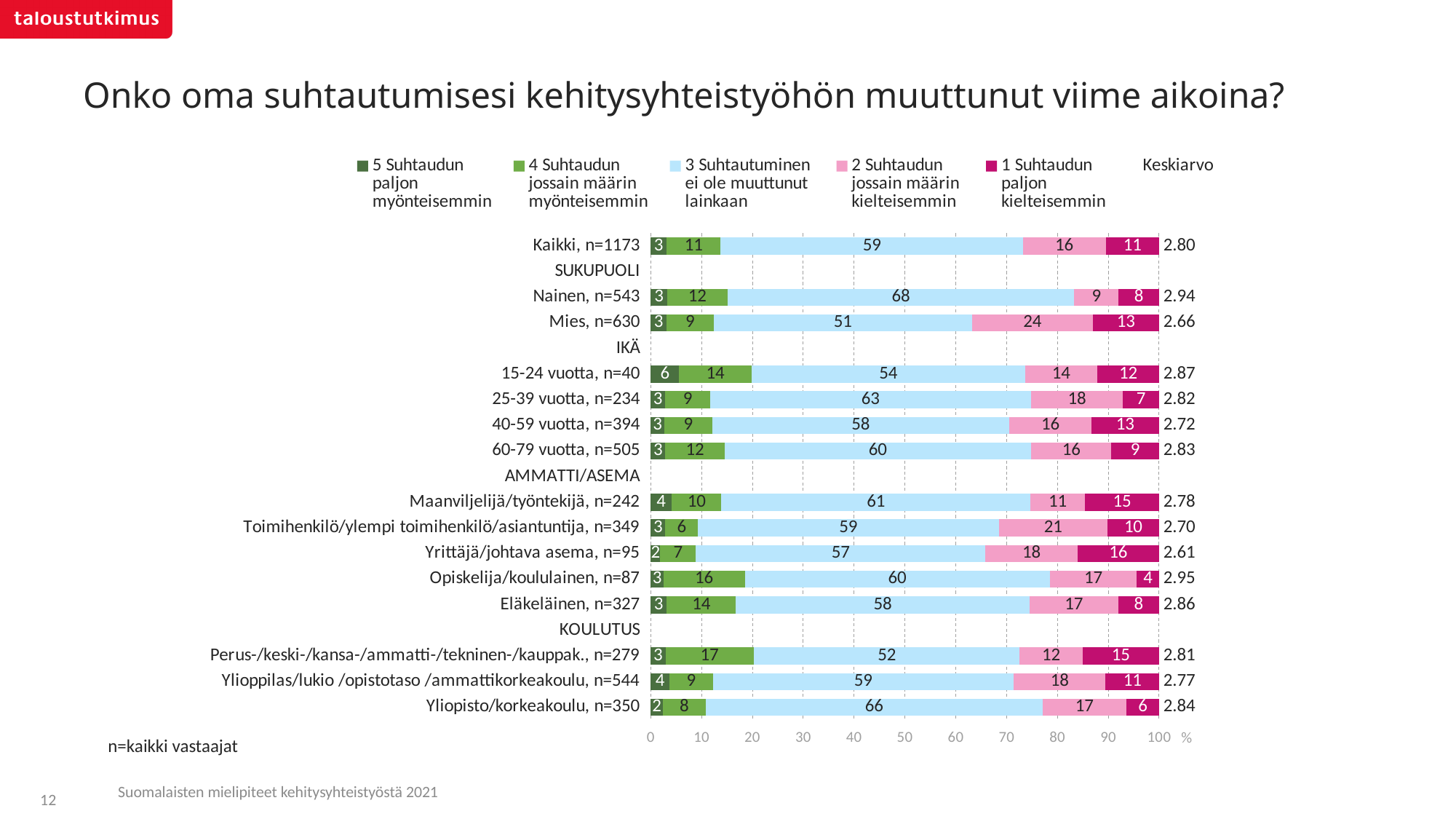
Which group has the lowest Keskiarvo? Yrittäjä/johtava asema, n=95 What is the value of '5 Suhtaudun paljon myönteisemmin' for '15-24 vuotta, n=40'? 6 What is the Keskiarvo for 'Nainen, n=543'? 2.94 How many coloured series does the legend list? 5 What is the value of '3 Suhtautuminen ei ole muuttunut lainkaan' for 'Kaikki, n=1173'? 59 What is the title of the chart? Onko oma suhtautumisesi kehitysyhteistyöhön muuttunut viime aikoina? Which group has the highest Keskiarvo? Opiskelija/koululainen, n=87 What kind of chart is shown on the slide? Stacked bar chart Which has a larger value for '1 Suhtaudun paljon kielteisemmin', 'Nainen, n=543' or 'Mies, n=630'? Mies, n=630 How many groups (bars) are plotted in the chart? 15 What is the value of '2 Suhtaudun jossain määrin kielteisemmin' for 'Mies, n=630'? 24 What is the difference in '3 Suhtautuminen ei ole muuttunut lainkaan' between 'Nainen, n=543' and 'Mies, n=630'? 17